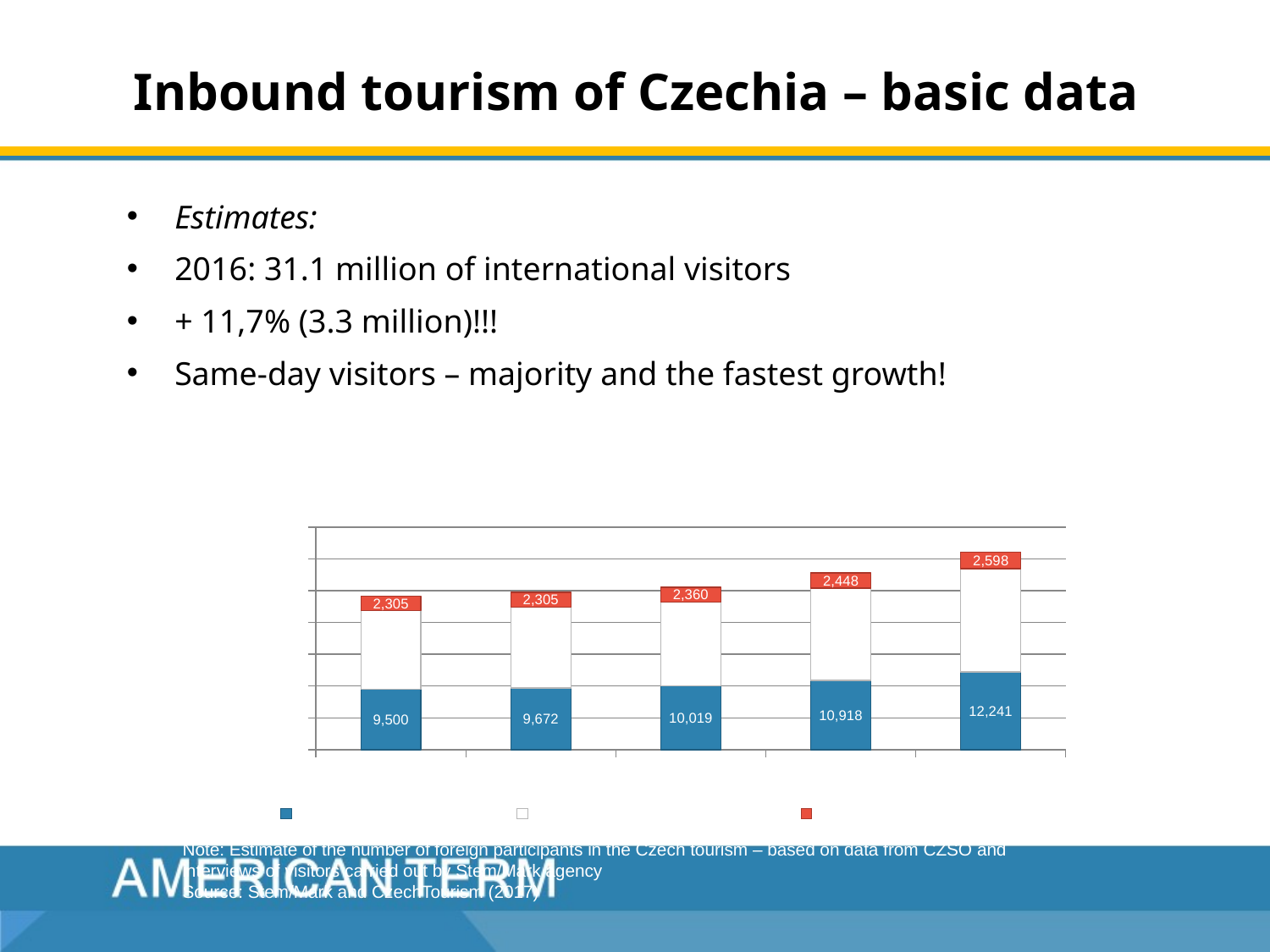
Which bar has the highest value for the blue (bottom) segment? the rightmost (fifth) bar Do the blue (bottom) segment values rise or fall from left to right across the bars? rise How many series does the chart's legend list? 3 What is the value of the blue (bottom) segment of the third bar from the left? 10,019 What is the difference between the blue segment values of the rightmost and leftmost bars? 2,741 Which bar has the lowest value for the blue (bottom) segment? the leftmost (first) bar How many stacked bars does the chart contain? 5 What is the value of the blue (bottom) segment of the leftmost bar? 9,500 What is the value of the red (top) segment of the rightmost bar? 2,598 Is the blue segment value of the fourth bar larger or smaller than that of the third bar? larger What kind of chart is shown on the slide? stacked bar chart What is the value of the red (top) segment of the fourth bar from the left? 2,448